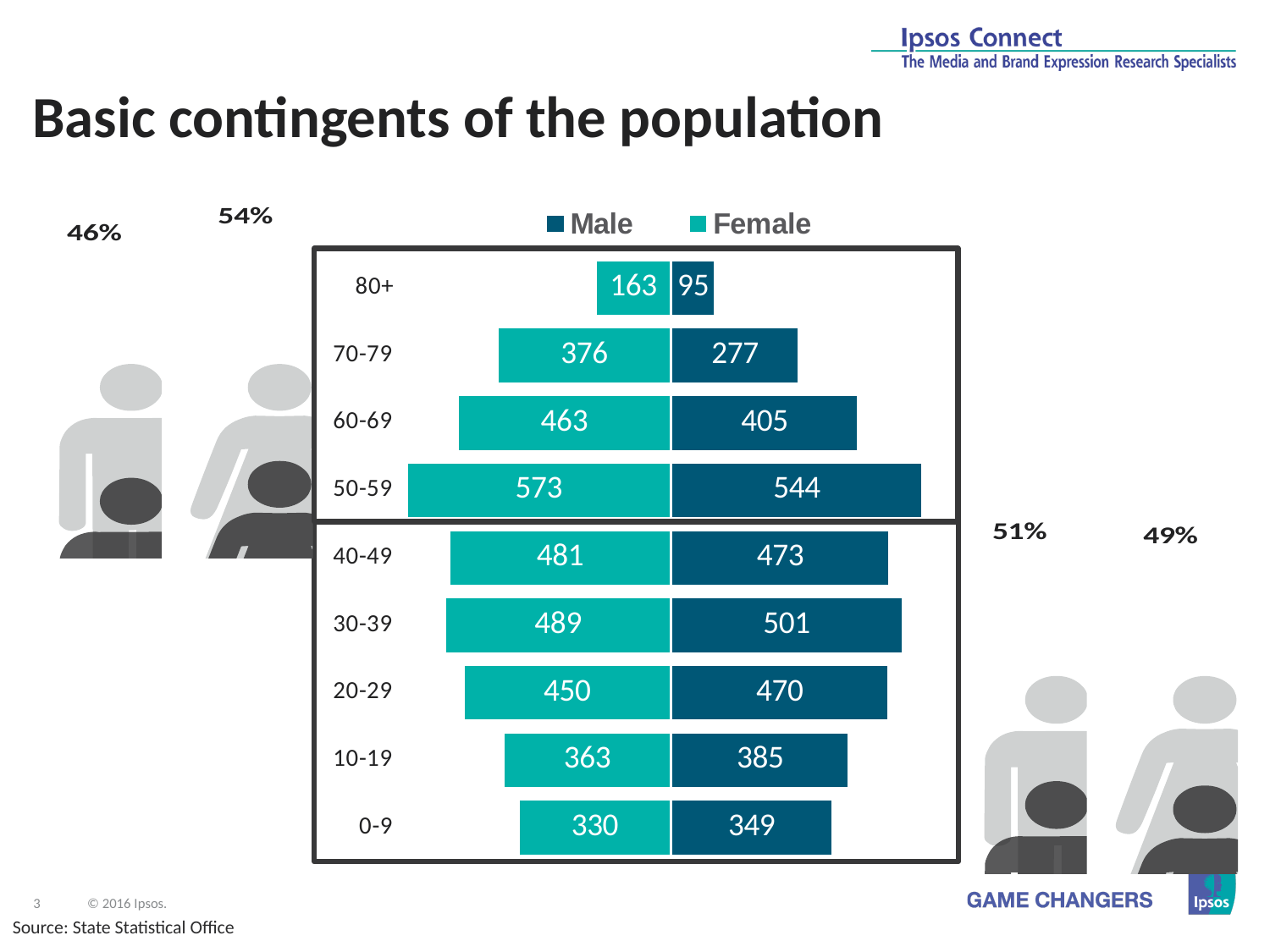
What kind of chart is shown on the slide? Bar chart How many age groups are shown in the chart? 9 What is the Male value for the 80+ age group? 95 What is the Male value for the 30-39 age group? 501 What is the difference between the Male and Female values for the 30-39 age group? 12 How many series does the legend list? 2 What is the difference between the Female and Male values for the 50-59 age group? 29 What is the combined Male and Female value for the 0-9 age group? 679 For the 20-29 age group, which is larger, the Male or the Female value? Male Which age group has the highest Female value? 50-59 What is the Female value for the 50-59 age group? 573 Which age group has the lowest Male value? 80+